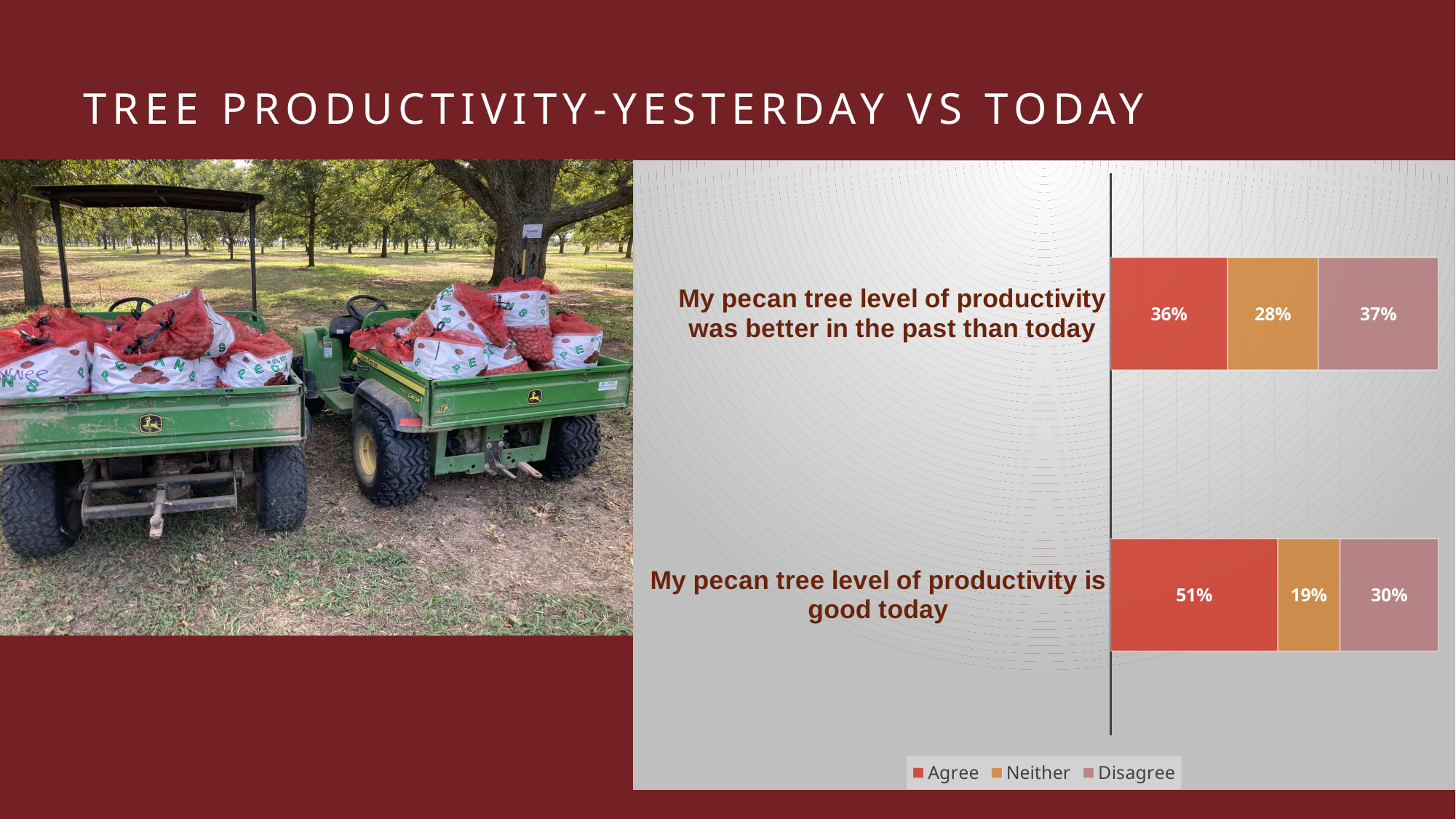
What percentage of respondents agree that their pecan tree level of productivity was better in the past than today? 36% What percentage of respondents disagree that their pecan tree level of productivity is good today? 30% What is the difference between the 'Agree' percentages for the two statements? 15% What type of chart is shown on the slide? Stacked bar chart Which statement has the higher 'Agree' percentage? My pecan tree level of productivity is good today How many series does the chart legend list? 3 Which response category has the lowest percentage for the statement 'My pecan tree level of productivity is good today'? Neither What are the three entries in the chart legend? Agree, Neither, Disagree How many statements (categories) are shown in the chart? 2 What is the 'Neither' value for the statement 'My pecan tree level of productivity is good today'? 19% What is the 'Disagree' value for the statement 'My pecan tree level of productivity was better in the past than today'? 37% What is the difference between the 'Neither' percentages for the two statements? 9%